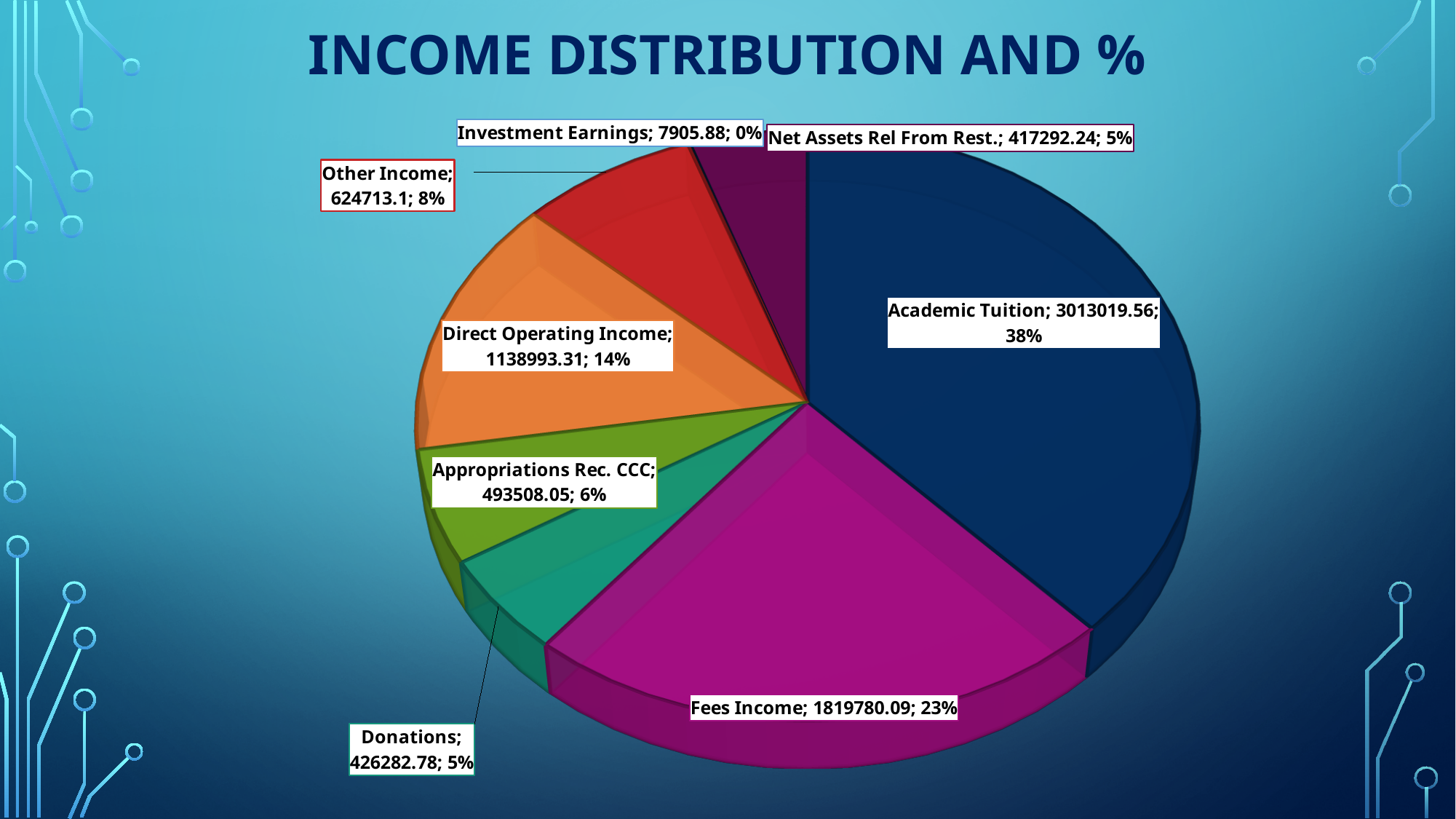
Which category has the smallest slice? Investment Earnings What percentage share does Appropriations Rec. CCC have? 6% What percentage share does Other Income have? 8% How many categories are shown in the pie chart? 8 What is the value for Direct Operating Income? 1138993.31 What is the title of the chart? INCOME DISTRIBUTION AND % Which is larger, Direct Operating Income or Other Income? Direct Operating Income What is the value for Fees Income? 1819780.09 What kind of chart is shown on the slide? Pie chart What is the value for Academic Tuition? 3013019.56 What is the difference between Academic Tuition and Fees Income? 1193239.47 Which category has the largest slice? Academic Tuition